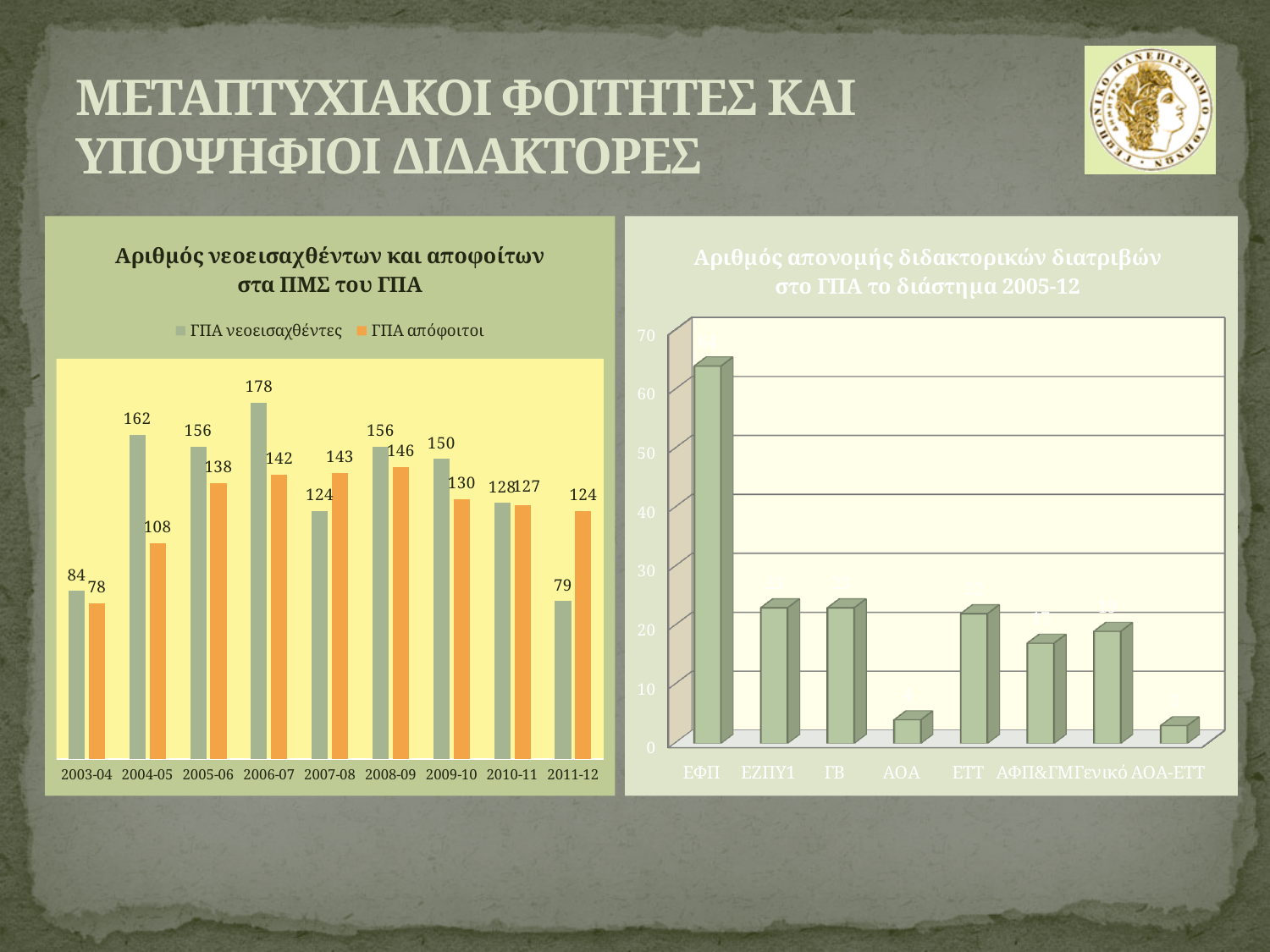
How many academic years are shown on the x axis of the chart 'Αριθμός νεοεισαχθέντων και αποφοίτων στα ΠΜΣ του ΓΠΑ'? 9 In the chart 'Αριθμός νεοεισαχθέντων και αποφοίτων στα ΠΜΣ του ΓΠΑ', what is the value for ΓΠΑ νεοεισαχθέντες in 2006-07? 178 In the chart 'Αριθμός απονομής διδακτορικών διατριβών στο ΓΠΑ το διάστημα 2005-12', is the value for ΕΦΠ greater or less than 60? greater What kind of chart is the chart on the right, 'Αριθμός απονομής διδακτορικών διατριβών στο ΓΠΑ το διάστημα 2005-12'? Bar chart In the chart 'Αριθμός νεοεισαχθέντων και αποφοίτων στα ΠΜΣ του ΓΠΑ', what is the difference between ΓΠΑ νεοεισαχθέντες and ΓΠΑ απόφοιτοι in 2004-05? 54 In the chart 'Αριθμός νεοεισαχθέντων και αποφοίτων στα ΠΜΣ του ΓΠΑ', which year has the highest value for ΓΠΑ νεοεισαχθέντες? 2006-07 In the chart 'Αριθμός νεοεισαχθέντων και αποφοίτων στα ΠΜΣ του ΓΠΑ', what is the value for ΓΠΑ απόφοιτοι in 2011-12? 124 In the chart 'Αριθμός απονομής διδακτορικών διατριβών στο ΓΠΑ το διάστημα 2005-12', which category has the highest value? ΕΦΠ In the chart 'Αριθμός νεοεισαχθέντων και αποφοίτων στα ΠΜΣ του ΓΠΑ', which is larger in 2007-08: ΓΠΑ νεοεισαχθέντες or ΓΠΑ απόφοιτοι? ΓΠΑ απόφοιτοι In the chart 'Αριθμός νεοεισαχθέντων και αποφοίτων στα ΠΜΣ του ΓΠΑ', which year has the lowest value for ΓΠΑ απόφοιτοι? 2003-04 How many categories are shown on the x axis of the chart 'Αριθμός απονομής διδακτορικών διατριβών στο ΓΠΑ το διάστημα 2005-12'? 8 How many series does the legend of the chart 'Αριθμός νεοεισαχθέντων και αποφοίτων στα ΠΜΣ του ΓΠΑ' list? 2